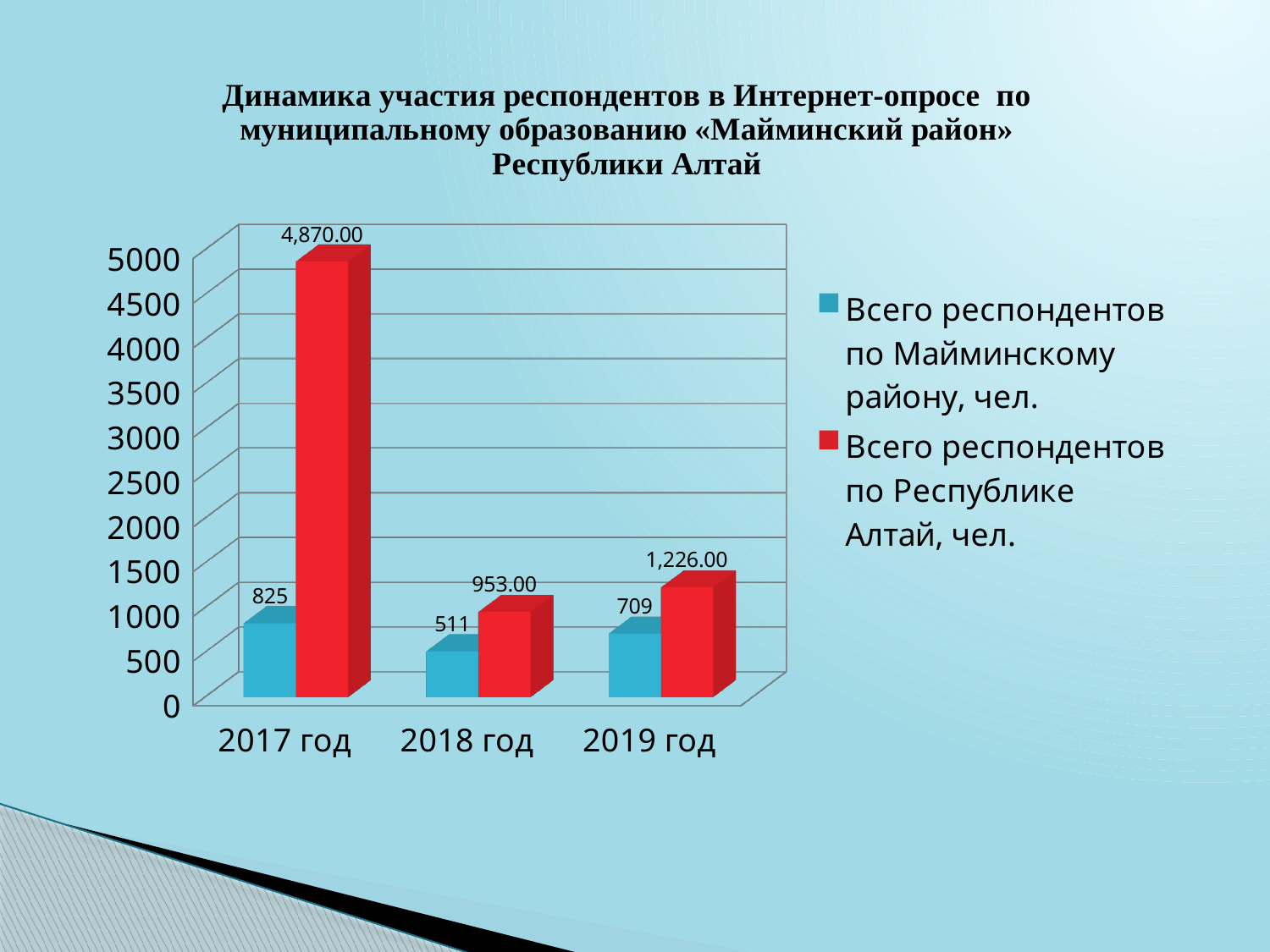
How many series does the legend list? 2 How many years are shown on the x axis? 3 Which year has the highest value for 'Всего респондентов по Республике Алтай, чел.'? 2017 год Is the value for 'Всего респондентов по Республике Алтай, чел.' in 2018 год greater or less than 1000? less Which year has the lowest value for 'Всего респондентов по Майминскому району, чел.'? 2018 год Which is larger: the 'Всего респондентов по Майминскому району, чел.' value for 2017 год or for 2019 год? 2017 год What kind of chart is shown on the slide? bar chart What is the value for 'Всего респондентов по Майминскому району, чел.' in 2018 год? 511 What is the value for 'Всего респондентов по Республике Алтай, чел.' in 2019 год? 1,226.00 What is the value for 'Всего респондентов по Майминскому району, чел.' in 2017 год? 825 What is the difference between the 'Всего респондентов по Республике Алтай, чел.' values for 2019 год and 2018 год? 273.00 What is the value for 'Всего респондентов по Республике Алтай, чел.' in 2017 год? 4,870.00